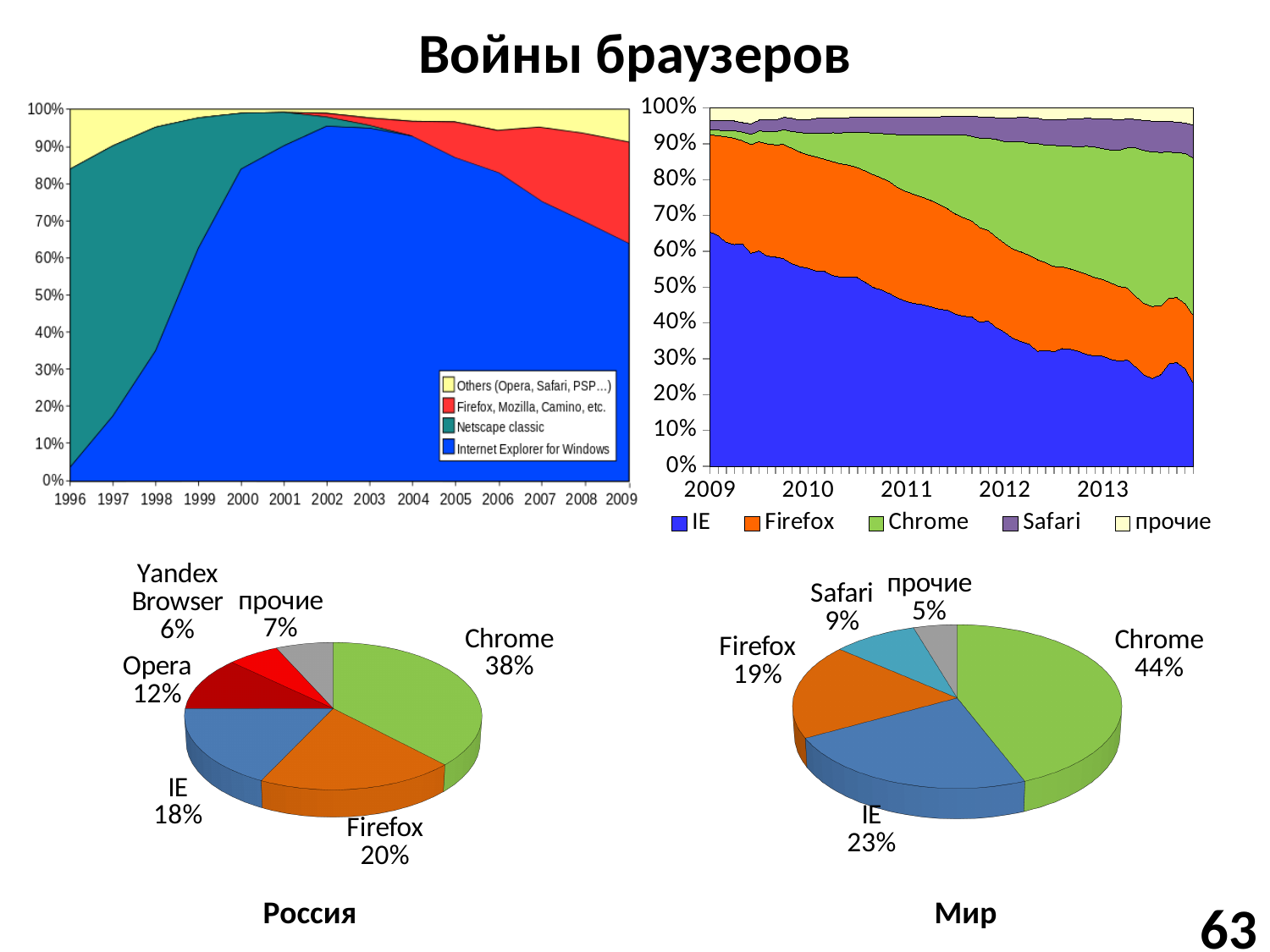
In the top-right area chart, does the share of IE rise or fall from 2009 to 2013? fall In the pie chart titled Россия, what share does Chrome have? 38% In the pie chart titled Мир, what share does IE have? 23% How many series does the legend of the top-right area chart list? 5 In the pie chart titled Россия, what is the difference in percentage points between Chrome and Firefox? 18 In the pie chart titled Мир, which category has the smallest share? прочие In the top-right area chart, is the value for IE at the start of 2009 greater or less than 60%? greater In the pie chart titled Россия, which browser has the largest share? Chrome In the pie chart titled Мир, what is the difference in percentage points between Chrome and IE? 21 In the pie chart titled Россия, which has a larger share, Opera or Yandex Browser? Opera What kind of chart is the chart titled Россия? pie chart How many slices does the pie chart titled Мир have? 5